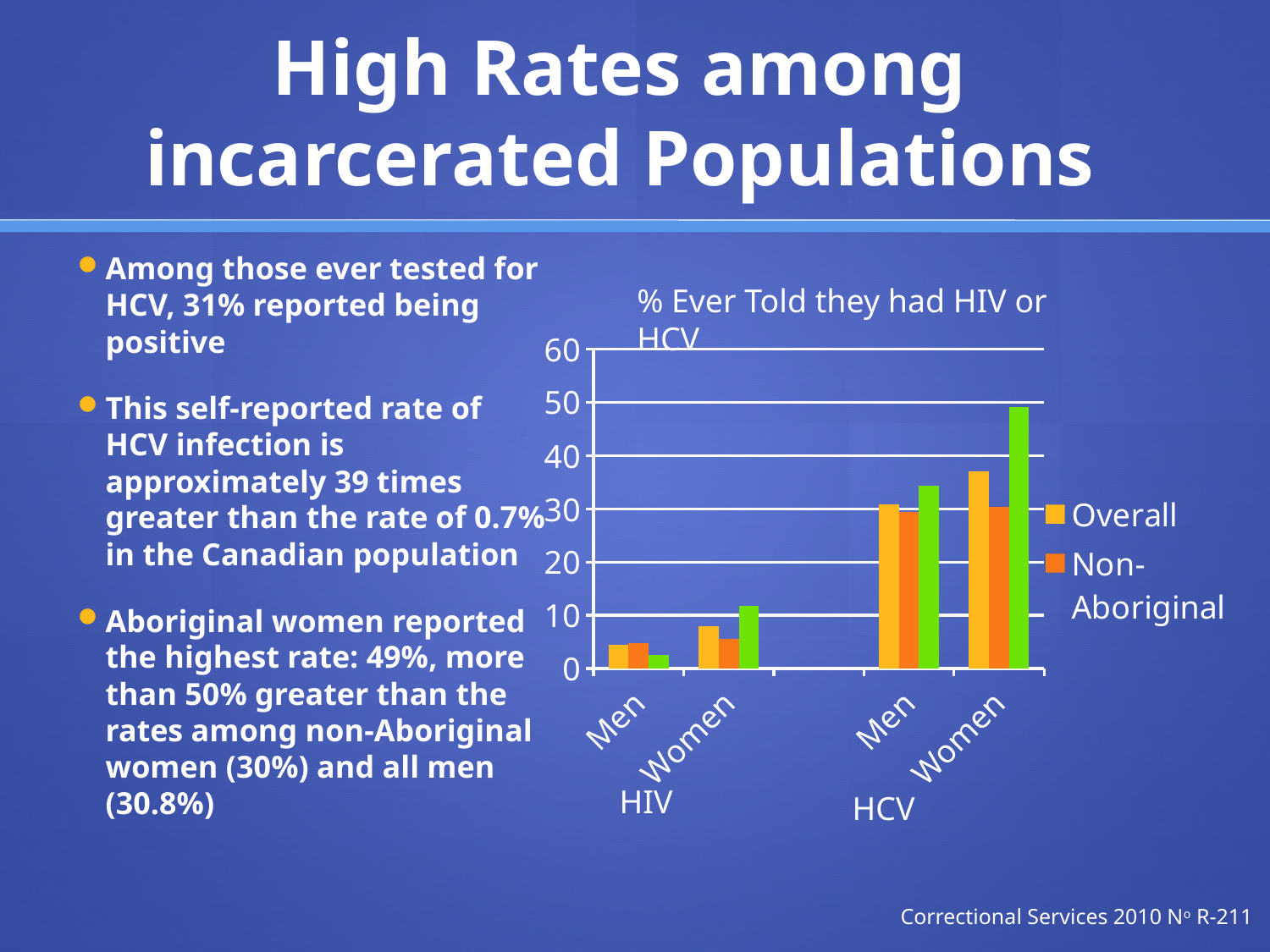
Is the value of the green bar for HCV Women greater or less than 40? greater How many category groups are shown along the x axis of the chart? 4 Is the value of the Overall bar for HIV Men greater or less than 10? less What kind of chart is shown on the slide? bar chart What is the highest value shown on the y axis of the chart? 60 Is the value of the Overall bar for HCV Women greater or less than 40? less Which category group has the tallest bar in the chart? HCV Women Which is larger, the green bar for HCV Women or the green bar for HCV Men? HCV Women Which category group contains the shortest bar in the chart? HIV Men Are the bars for HCV higher or lower than the bars for HIV? higher What is the title of the chart? % Ever Told they had HIV or HCV